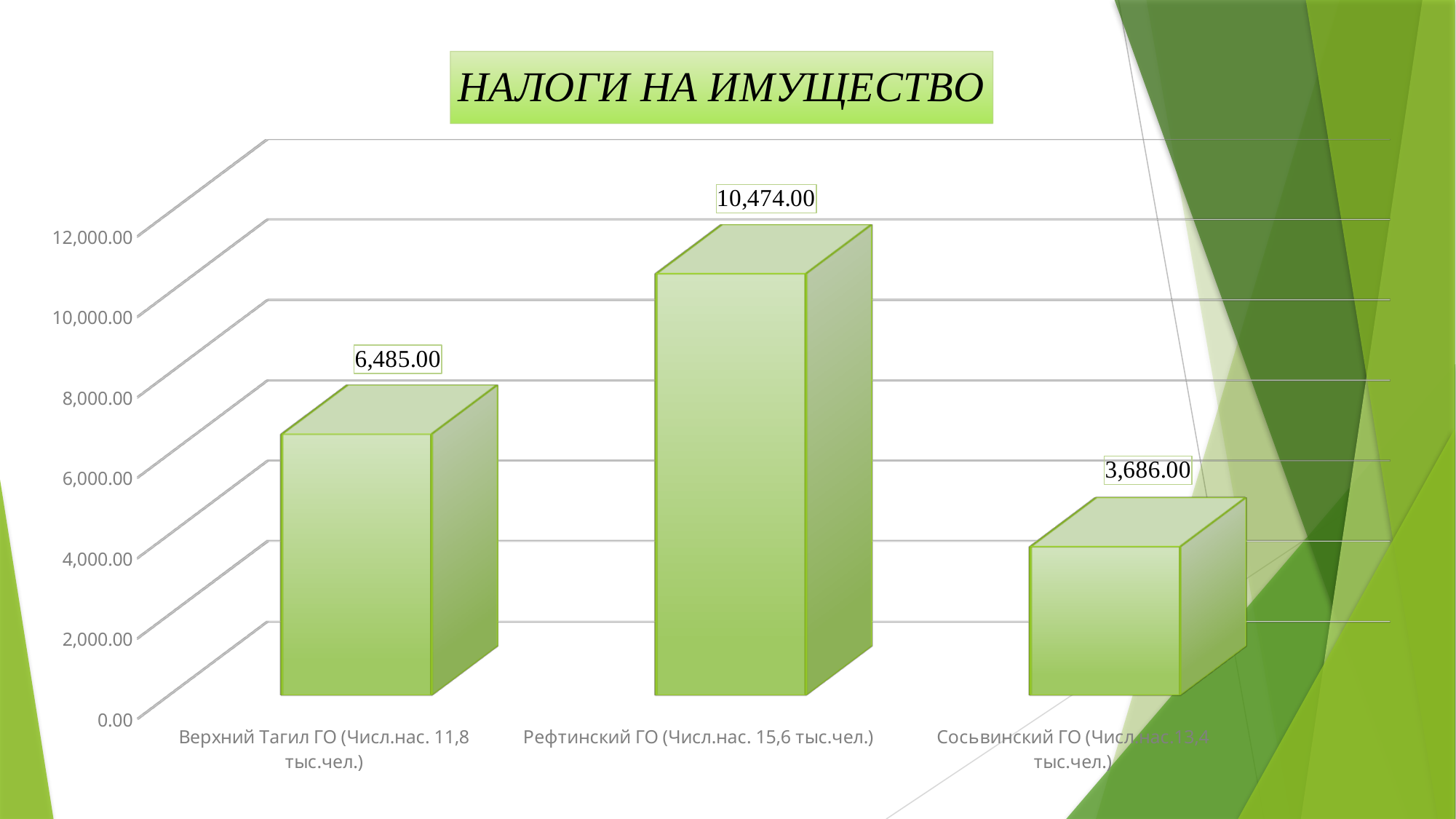
What is the difference between the values for Рефтинский ГО and Верхний Тагил ГО? 3,989.00 What is the value for Сосьвинский ГО? 3,686.00 Which is larger, the value for Верхний Тагил ГО or the value for Сосьвинский ГО? Верхний Тагил ГО What kind of chart is shown on the slide? bar chart What is the value for Рефтинский ГО? 10,474.00 What is the value for Верхний Тагил ГО? 6,485.00 What is the difference between the values for Верхний Тагил ГО and Сосьвинский ГО? 2,799.00 What is the title of the chart? НАЛОГИ НА ИМУЩЕСТВО Which category has the highest value? Рефтинский ГО Is the value for Рефтинский ГО greater or less than 10,000.00? greater How many categories are shown in the chart? 3 Which category has the lowest value? Сосьвинский ГО